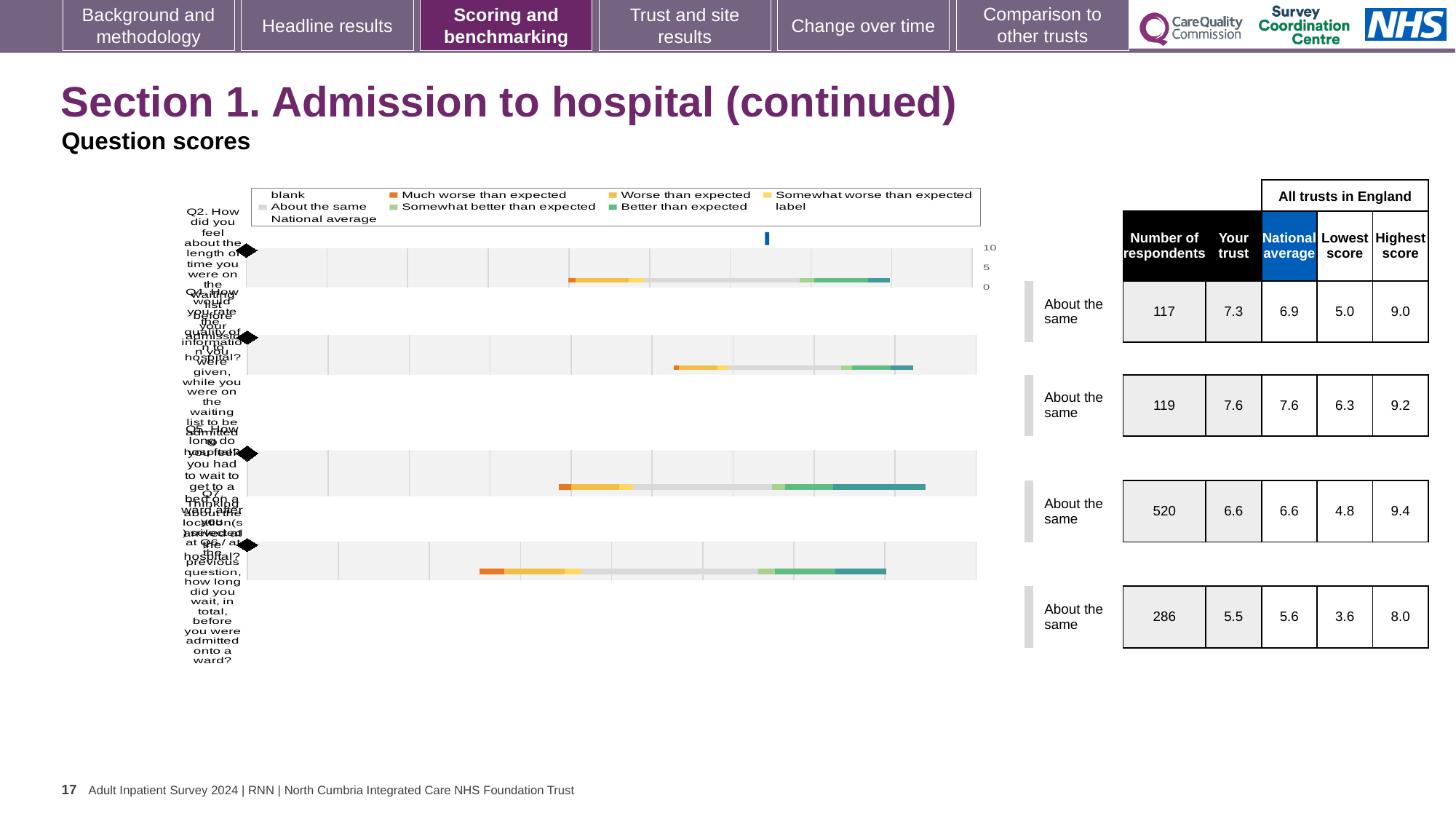
How many horizontal bars are plotted in the chart? 4 In the table, what is the lowest score in the fourth row? 3.6 In the table, what is the number of respondents in the first row? 117 In the table, what is the national average in the fourth row? 5.6 In the table, what is the difference between the highest score and the lowest score in the first row? 4.0 What kind of chart is shown on the slide? bar chart In the table, what is the highest score in the third row? 9.4 What benchmark category is shown next to each of the four rows? About the same In the table, what is the 'Your trust' score in the second row? 7.6 In the table, which row has the largest number of respondents? the third row (520) What is the highest value shown on the chart's numeric axis? 10 Which legend entry is shown in dark orange? Much worse than expected